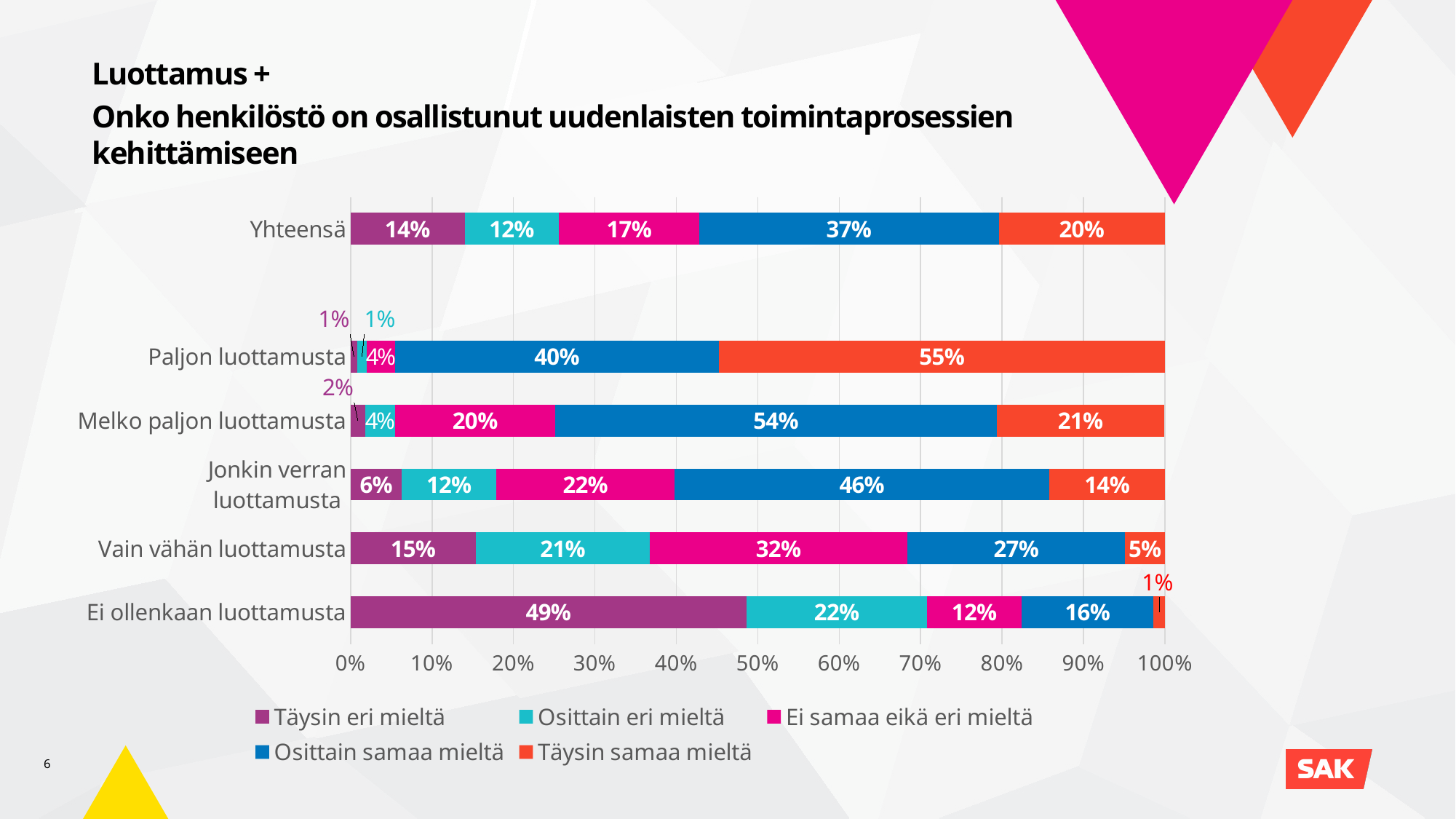
Which category has the highest value for 'Osittain samaa mieltä'? Melko paljon luottamusta What is the value of 'Täysin eri mieltä' for 'Ei ollenkaan luottamusta'? 49% How many series does the legend list? 5 What is the total of the 'Täysin eri mieltä' and 'Osittain eri mieltä' segments for 'Ei ollenkaan luottamusta'? 71% What type of chart is shown on the slide? stacked bar chart What is the difference between the 'Täysin samaa mieltä' values for 'Paljon luottamusta' and 'Melko paljon luottamusta'? 34% What is the value of 'Ei samaa eikä eri mieltä' for 'Vain vähän luottamusta'? 32% What is the value of 'Täysin samaa mieltä' for 'Paljon luottamusta'? 55% How many categories are shown on the vertical axis of the chart? 6 Which category has the lowest value for 'Täysin samaa mieltä'? Ei ollenkaan luottamusta Which is larger: the 'Osittain eri mieltä' value for 'Vain vähän luottamusta' or for 'Jonkin verran luottamusta'? Vain vähän luottamusta What is the value of 'Osittain samaa mieltä' for 'Yhteensä'? 37%